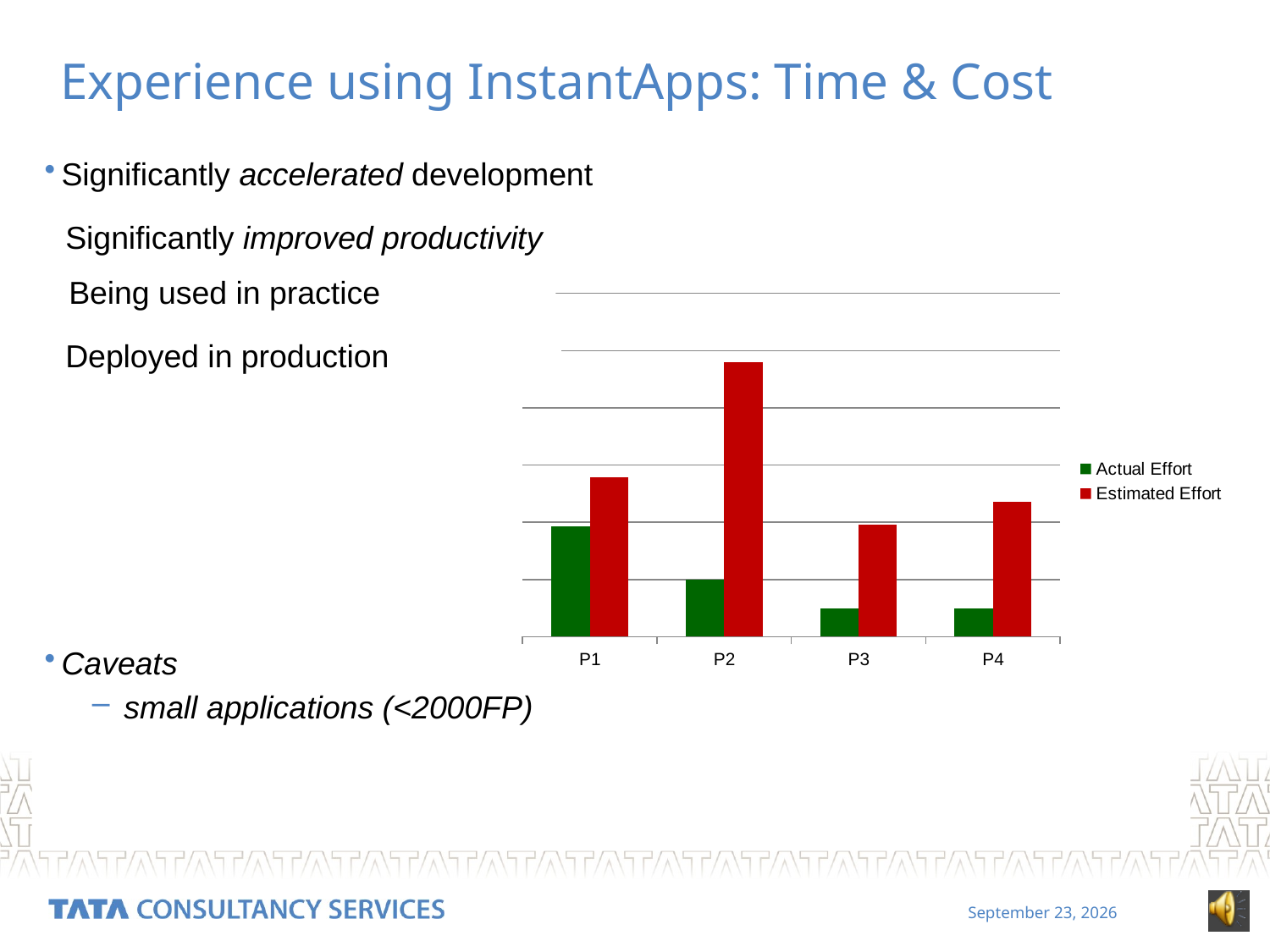
Which colour represents Actual Effort in the chart? green How many categories are shown on the x axis of the chart? 4 Which category has the lowest Estimated Effort? P3 Which category has the highest Actual Effort? P1 For P1, which is larger: Actual Effort or Estimated Effort? Estimated Effort For P2, which is larger: Actual Effort or Estimated Effort? Estimated Effort Which is larger: the Actual Effort for P1 or the Actual Effort for P2? P1 What kind of chart is shown on the slide? bar chart What are the two series named in the chart's legend? Actual Effort and Estimated Effort How many series does the chart's legend list? 2 Which category has the highest Estimated Effort? P2